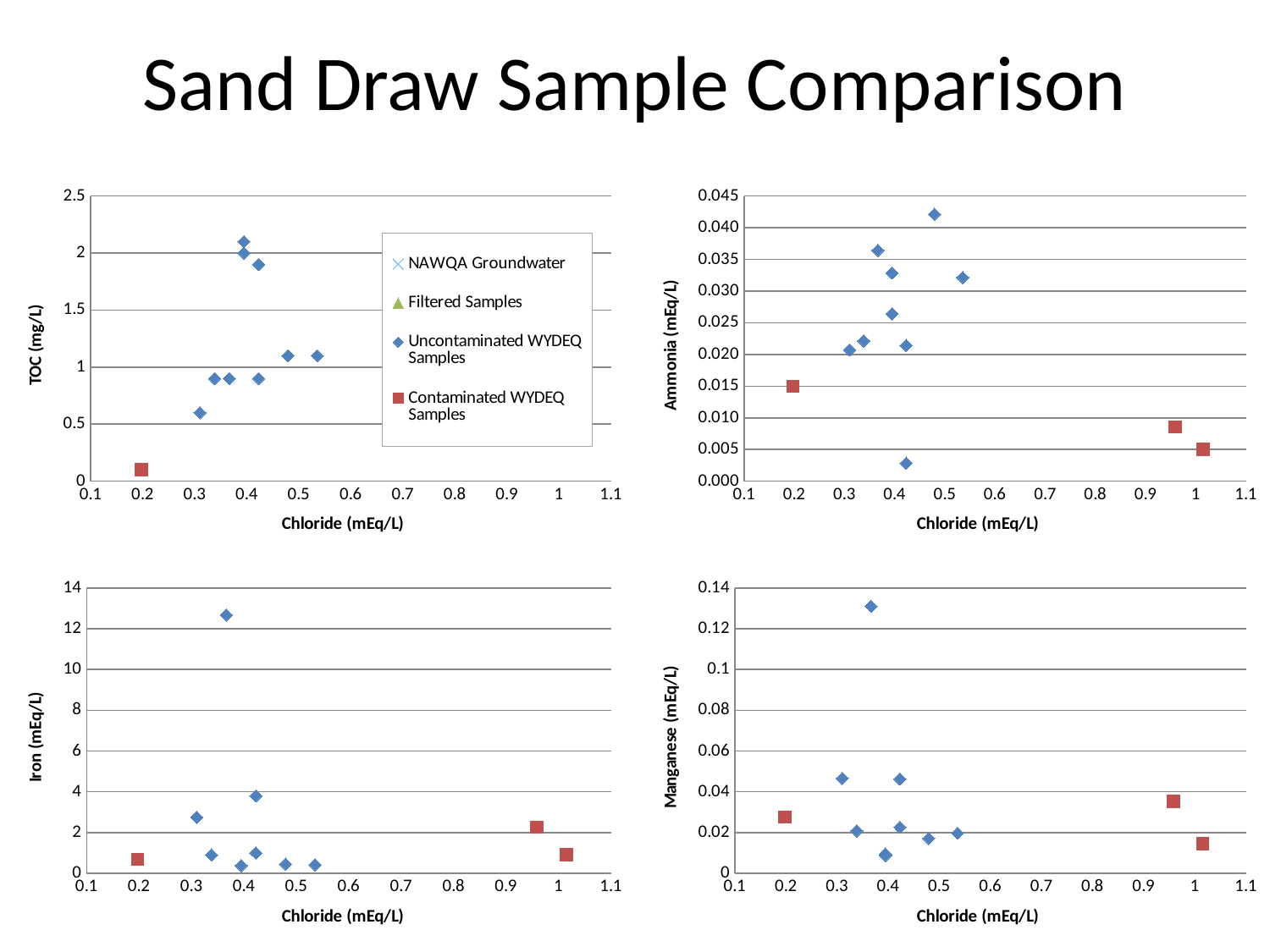
What is the x-axis title of the top-right chart? Chloride (mEq/L) What is the y-axis title of the bottom-right chart? Manganese (mEq/L) In the bottom-left Iron chart, is the highest Iron value greater or less than 12? greater In the top-right Ammonia chart, is the lowest Uncontaminated WYDEQ Samples value greater or less than 0.005? less How many series does the legend on the top-left chart list? 4 In the top-left TOC chart, is the TOC value of the Contaminated WYDEQ Samples point greater or less than 0.5? less In the bottom-left Iron chart, how many Contaminated WYDEQ Samples points are plotted? 3 In the bottom-right Manganese chart, which Contaminated WYDEQ Samples point has the higher Manganese value: the one near chloride 0.2 or the one near chloride 1.0? the one near chloride 0.2 What kind of chart is the top-left chart (TOC vs Chloride)? scatter chart In the top-right Ammonia chart, how many Contaminated WYDEQ Samples points are plotted? 3